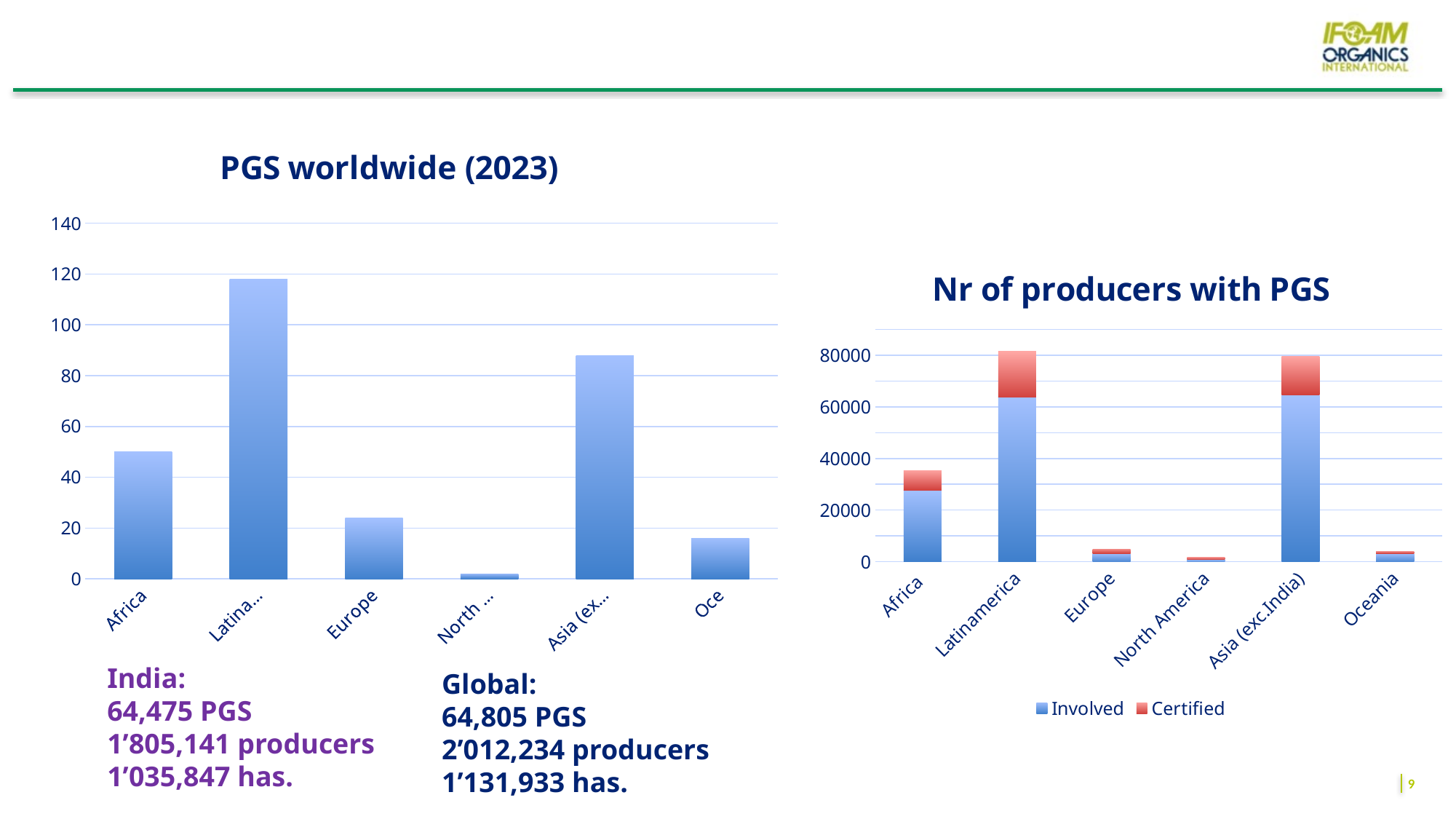
What kind of chart is the 'PGS worldwide (2023)' chart? bar chart On the 'PGS worldwide (2023)' chart, is the value for Africa greater or less than 40? greater On the 'Nr of producers with PGS' chart, which has the larger total, Africa or Oceania? Africa What is the highest value shown on the vertical axis of the 'PGS worldwide (2023)' chart? 140 How many categories are shown on the 'PGS worldwide (2023)' chart? 6 How many series does the legend of the 'Nr of producers with PGS' chart list? 2 On the 'Nr of producers with PGS' chart, is the total for Africa greater or less than 20000? greater On the 'PGS worldwide (2023)' chart, which has the larger value, Africa or Europe? Africa What are the two series named in the legend of the 'Nr of producers with PGS' chart? Involved and Certified On the 'Nr of producers with PGS' chart, is the total for Europe greater or less than 20000? less On the 'Nr of producers with PGS' chart, which category has the lowest total? North America